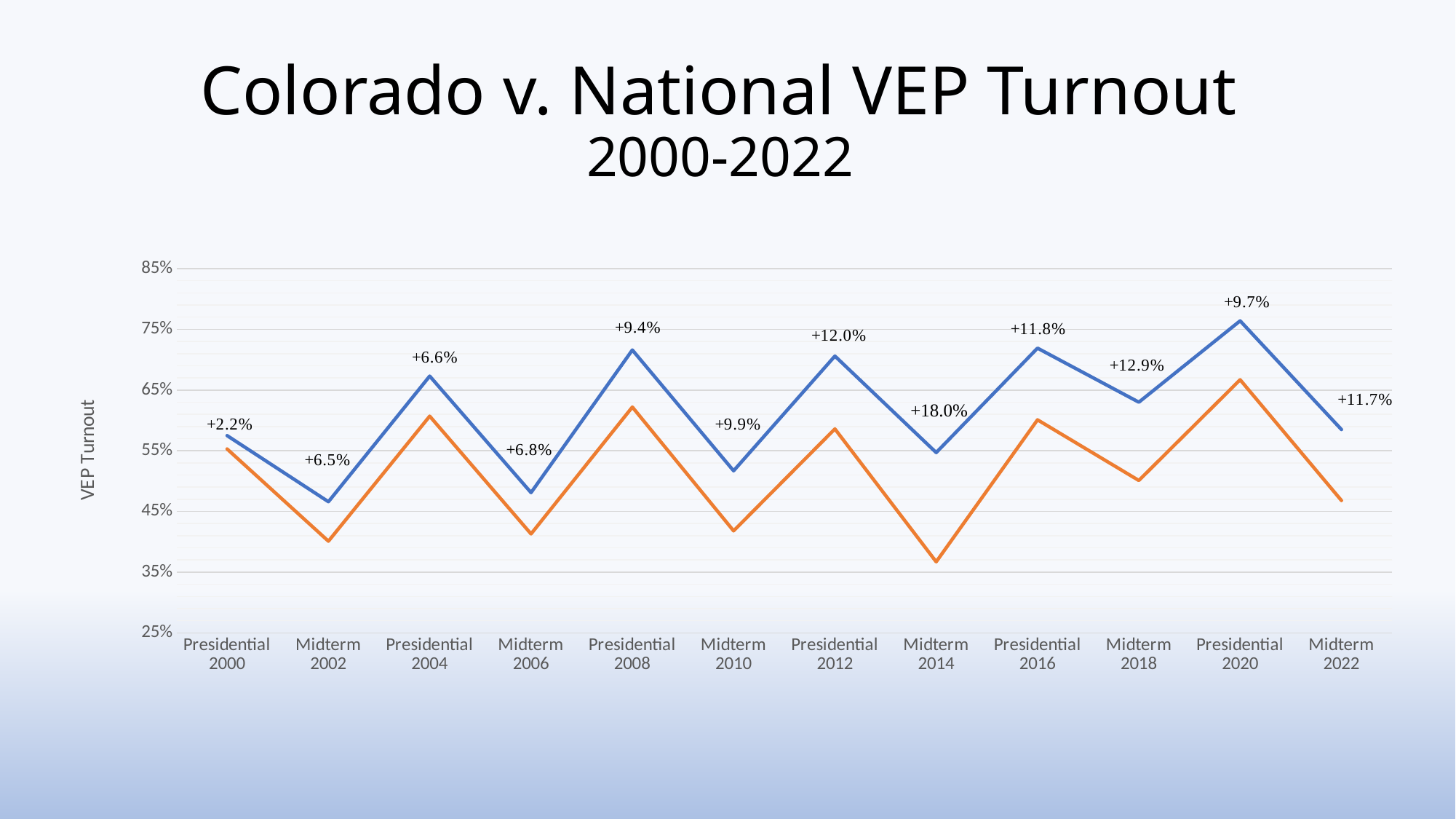
What is the title of the chart on the slide? Colorado v. National VEP Turnout 2000-2022 At which election is the smallest printed difference label shown? Presidential 2000 Is the value of the blue line at Presidential 2008 greater or less than 65%? greater How many election points are plotted along the x axis? 12 What difference label is printed at the Midterm 2018 point? +12.9% What difference label is printed at the Presidential 2008 point? +9.4% At which election is the largest printed difference label shown? Midterm 2014 Is the value of the orange line at Midterm 2014 greater or less than 45%? less How many lines are plotted on the chart? 2 What kind of chart is shown on the slide? line chart Which line is higher at Presidential 2012, the blue line or the orange line? blue line Is the value of the blue line at Midterm 2002 greater or less than 55%? less